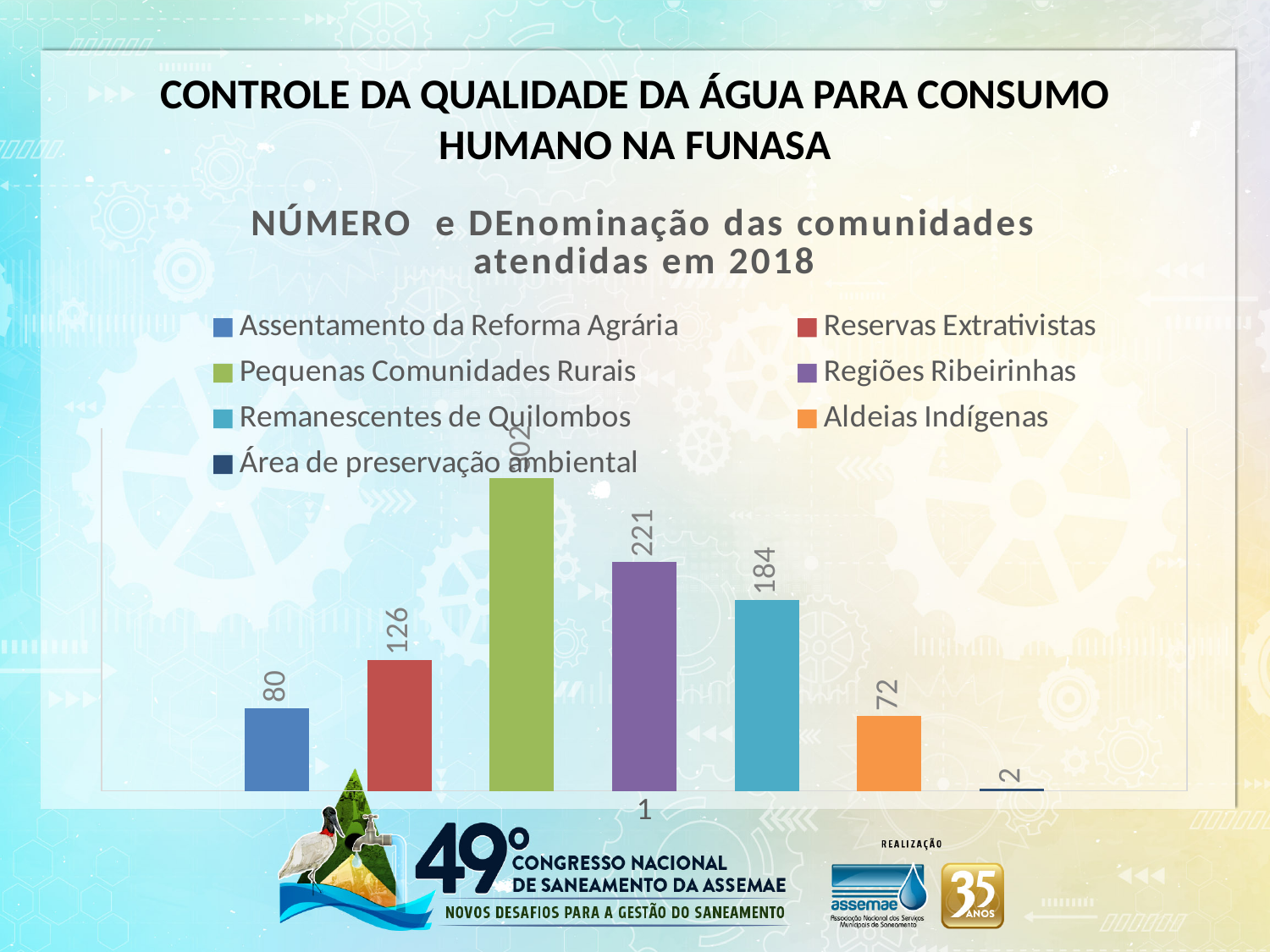
What is the value for Assentamento da Reforma Agrária? 80 What is the difference between the values for Regiões Ribeirinhas and Remanescentes de Quilombos? 37 Which is larger, the value for Reservas Extrativistas or the value for Aldeias Indígenas? Reservas Extrativistas What is the value for Área de preservação ambiental? 2 How many series does the legend list? 7 What is the value for Reservas Extrativistas? 126 Which category has the lowest value? Área de preservação ambiental What is the value for Aldeias Indígenas? 72 What kind of chart is shown on the slide? Bar chart What is the value for Regiões Ribeirinhas? 221 Which category has the highest value? Pequenas Comunidades Rurais What is the value for Remanescentes de Quilombos? 184